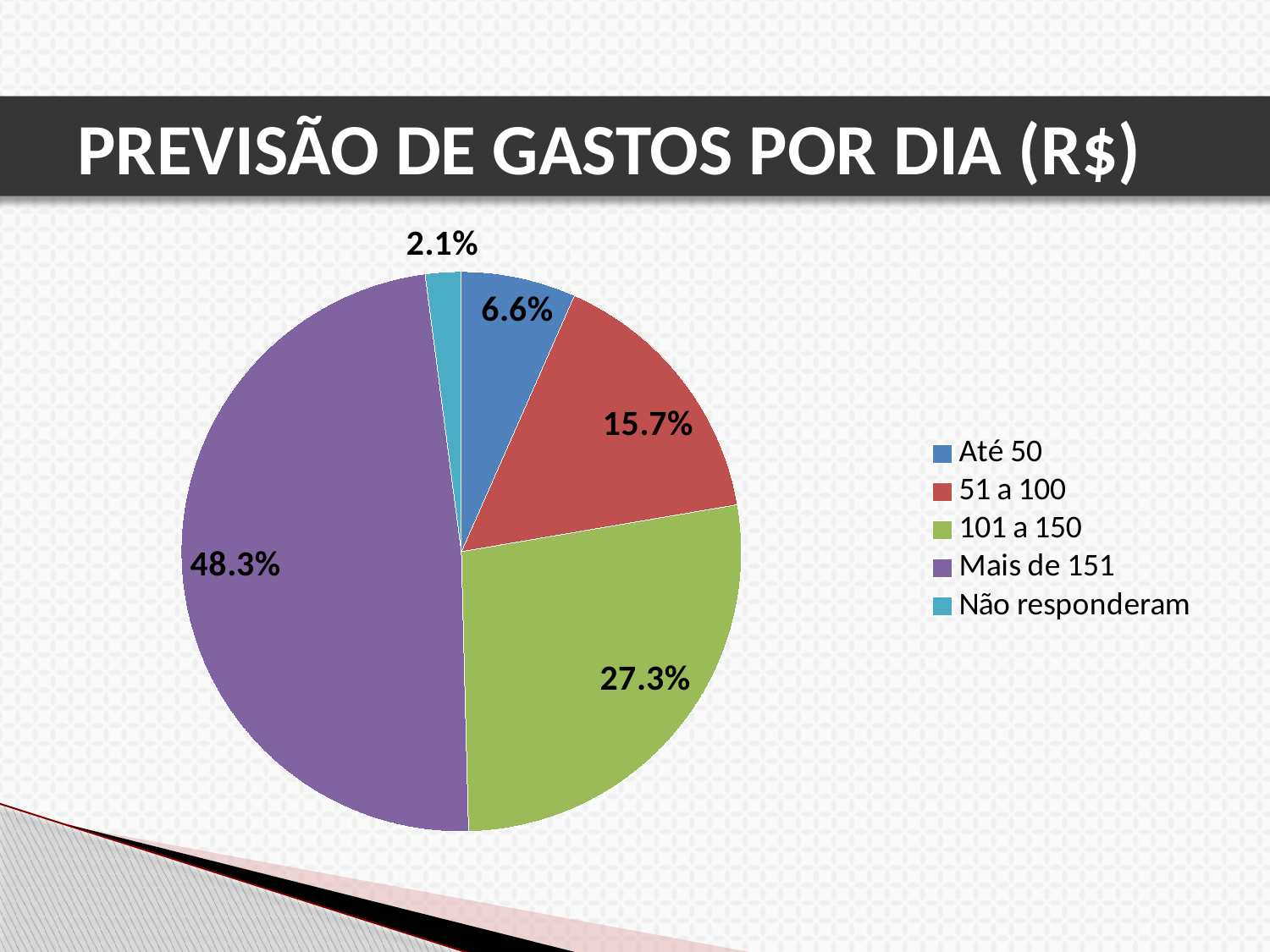
What is the share for '101 a 150'? 27.3% Which category has the largest slice? Mais de 151 What is the share for '51 a 100'? 15.7% What is the share for 'Mais de 151'? 48.3% What is the share for 'Não responderam'? 2.1% What is the title of the chart? PREVISÃO DE GASTOS POR DIA (R$) Which category has the smallest slice? Não responderam What is the share for 'Até 50'? 6.6% What is the difference in percentage points between '101 a 150' and '51 a 100'? 11.6 What kind of chart is shown on the slide? pie chart Which is larger, the share for 'Até 50' or the share for '51 a 100'? 51 a 100 How many categories does the legend list? 5